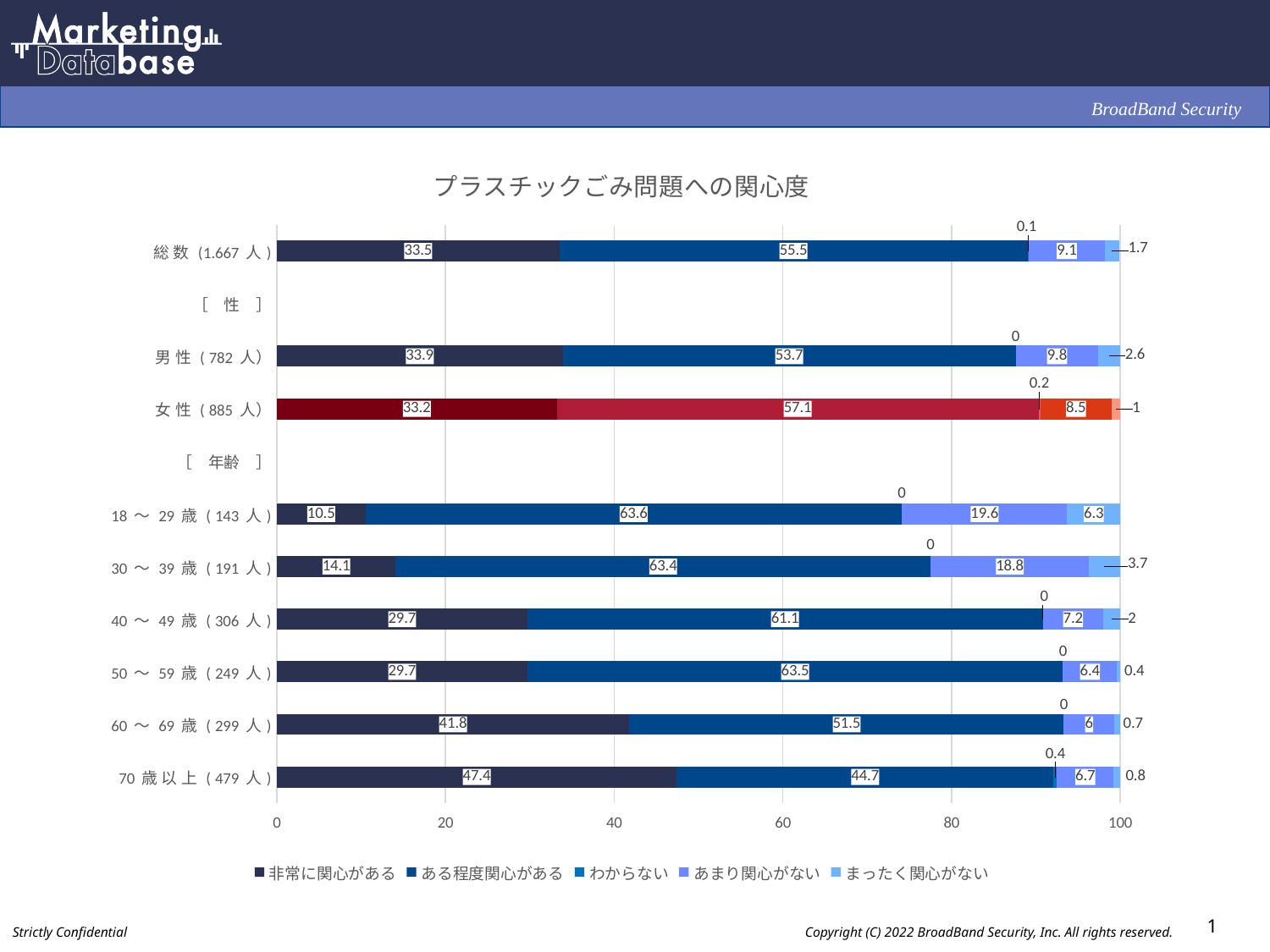
What kind of chart is shown on the slide? Stacked bar chart Which category has the highest value for 非常に関心がある? 70歳以上 (479人) What is the title of the chart? プラスチックごみ問題への関心度 Which is larger: the 非常に関心がある value for 60〜69歳 (299人) or for 70歳以上 (479人)? 70歳以上 (479人) What is the value of ある程度関心がある for 女性 (885人)? 57.1 Which category has the lowest value for 非常に関心がある? 18〜29歳 (143人) How many series does the legend list? 5 What is the value of あまり関心がない for 18〜29歳 (143人)? 19.6 What is the value of 非常に関心がある for 総数 (1,667人)? 33.5 What is the total of the stacked bar for 男性 (782人)? 100 What is the value of まったく関心がない for 男性 (782人)? 2.6 What is the difference between the ある程度関心がある values for 女性 (885人) and 男性 (782人)? 3.4